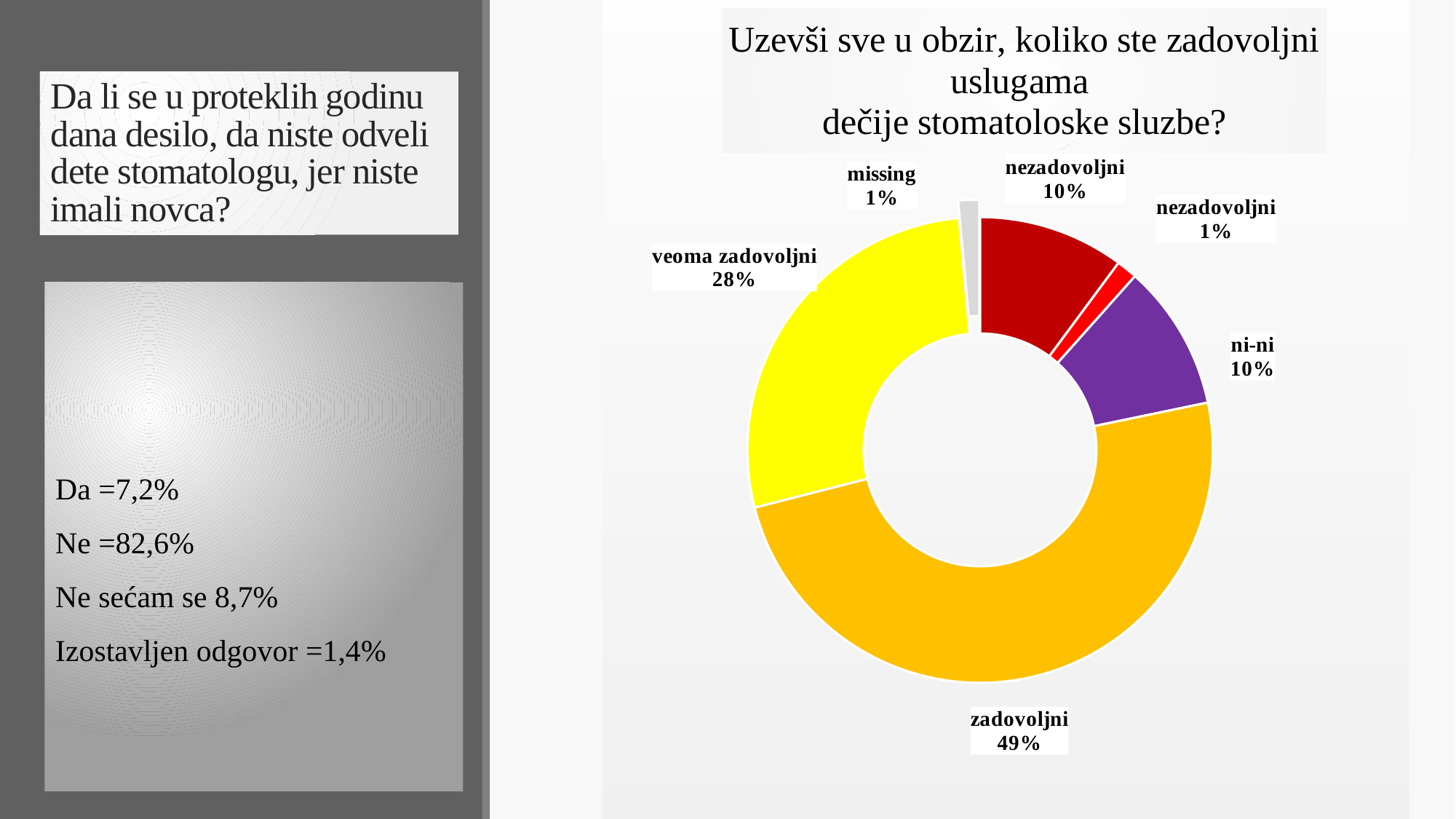
What percentage of respondents answered "zadovoljni"? 49% How many percentage points larger is "zadovoljni" than "veoma zadovoljni"? 21% What percentage of respondents answered "veoma zadovoljni"? 28% What is the combined percentage of "zadovoljni" and "veoma zadovoljni"? 77% What percentage is shown for the "missing" slice? 1% How many slices does the chart have? 6 What percentage is shown for the "ni-ni" slice? 10% Which category has the largest slice of the chart? zadovoljni What colour is the "zadovoljni" slice? orange What share of the chart does the "zadovoljni" slice take? 49% What kind of chart is shown on the slide? doughnut chart Which is larger, the "ni-ni" slice or the "veoma zadovoljni" slice? veoma zadovoljni